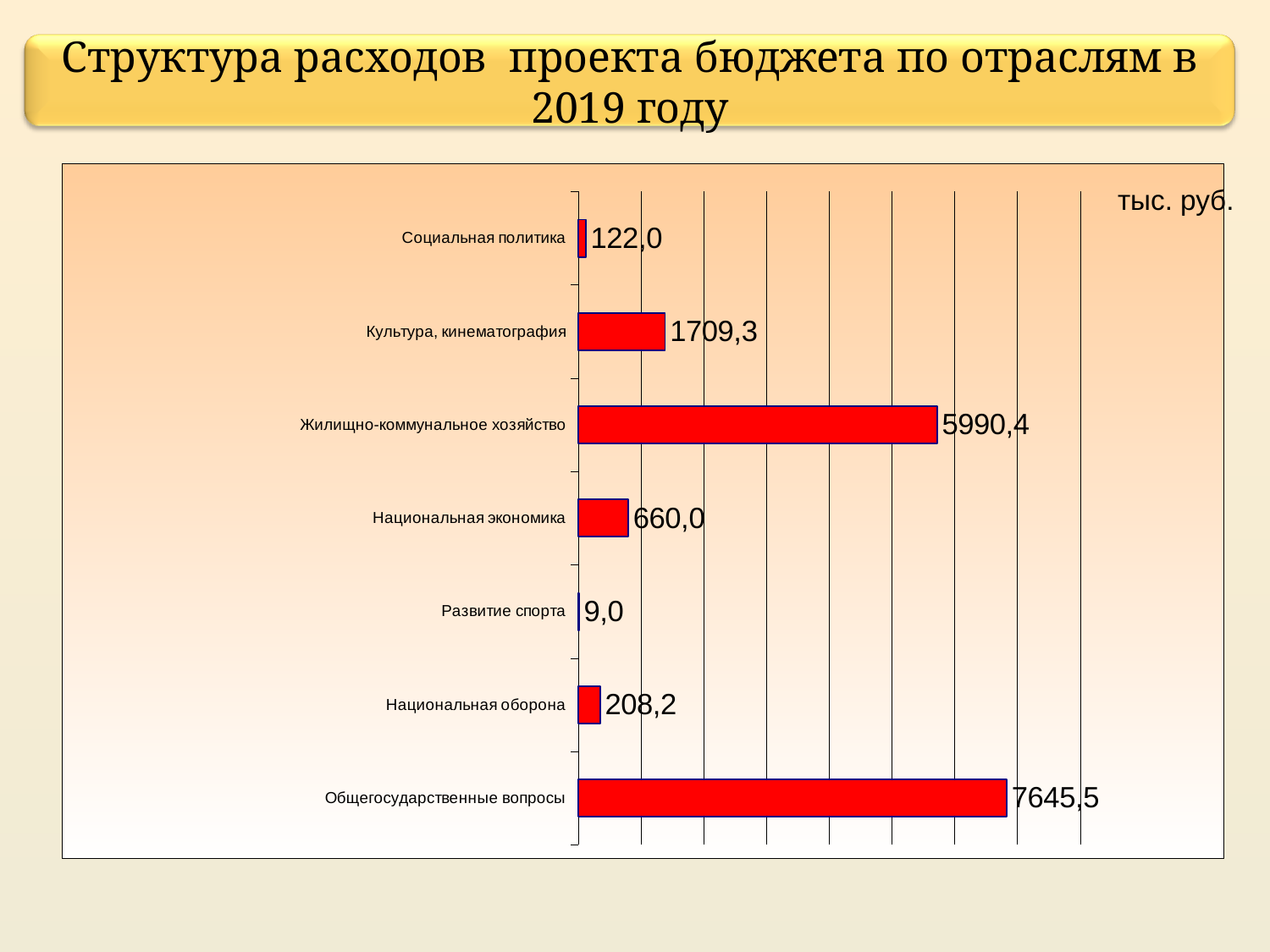
What is the value for Культура, кинематография? 1709,3 What is the difference between Общегосударственные вопросы and Жилищно-коммунальное хозяйство? 1655,1 What kind of chart is shown on the slide? Bar chart Which is larger, Национальная оборона or Социальная политика? Национальная оборона What is the difference between Культура, кинематография and Национальная экономика? 1049,3 How many categories are shown in the chart? 7 Which category has the highest value? Общегосударственные вопросы What unit is indicated in the top right corner of the chart? тыс. руб. Which category has the lowest value? Развитие спорта What is the value for Национальная оборона? 208,2 What is the value for Развитие спорта? 9,0 What is the value for Жилищно-коммунальное хозяйство? 5990,4